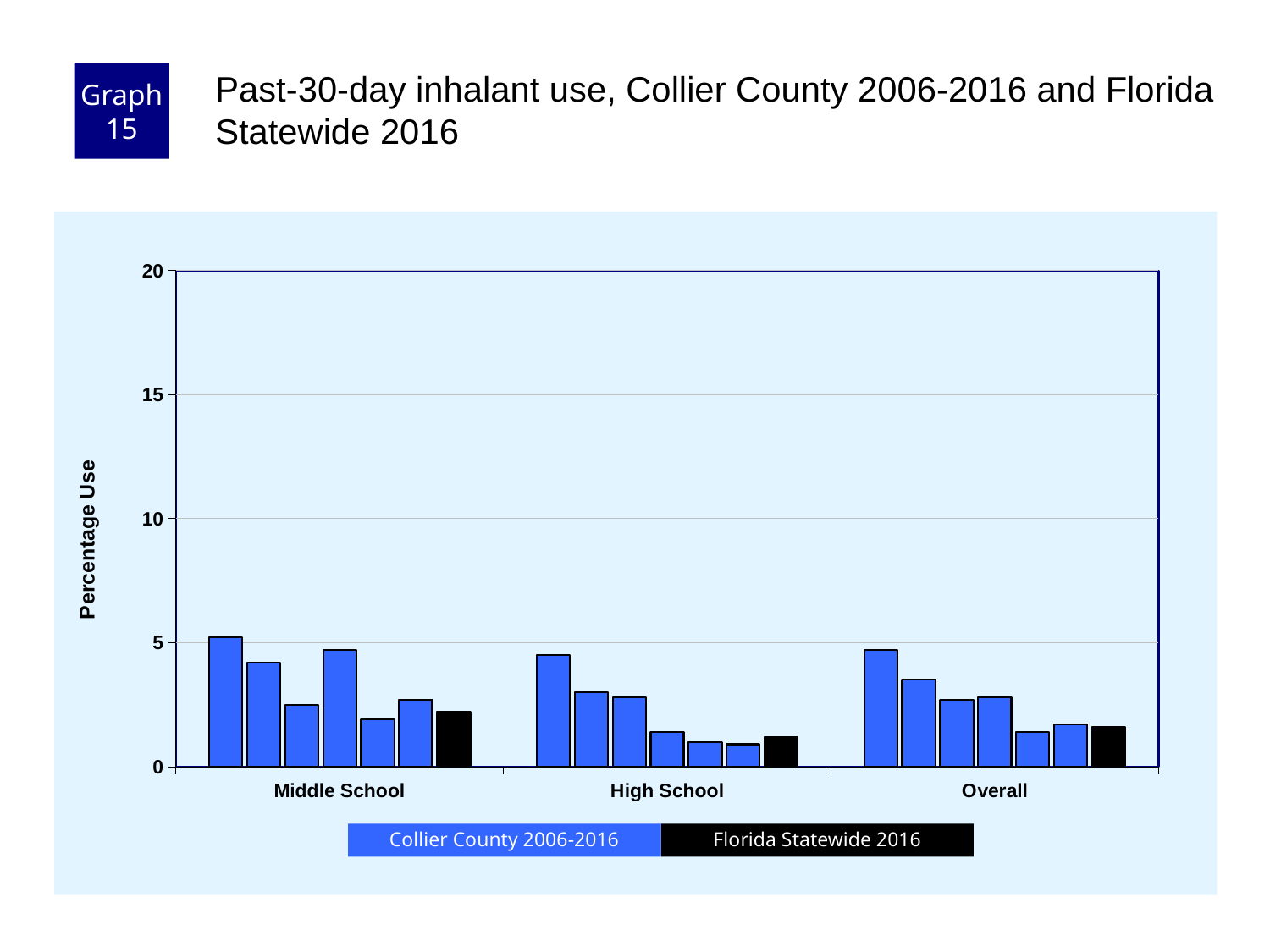
Among the three categories, which has the highest Florida Statewide 2016 value? Middle School What kind of chart is shown on the slide? bar chart What is the label on the y axis? Percentage Use How many series does the legend list? 2 Is the Florida Statewide 2016 value for Middle School greater or less than 5? less Which is larger, the Florida Statewide 2016 value for Middle School or for Overall? Middle School Are any of the High School bars greater or less than 10? less What is the title of the chart? Past-30-day inhalant use, Collier County 2006-2016 and Florida Statewide 2016 Is the Florida Statewide 2016 value for Overall greater or less than 5? less Which is larger, the Florida Statewide 2016 value for Middle School or for High School? Middle School How many school-level categories are shown on the x axis? 3